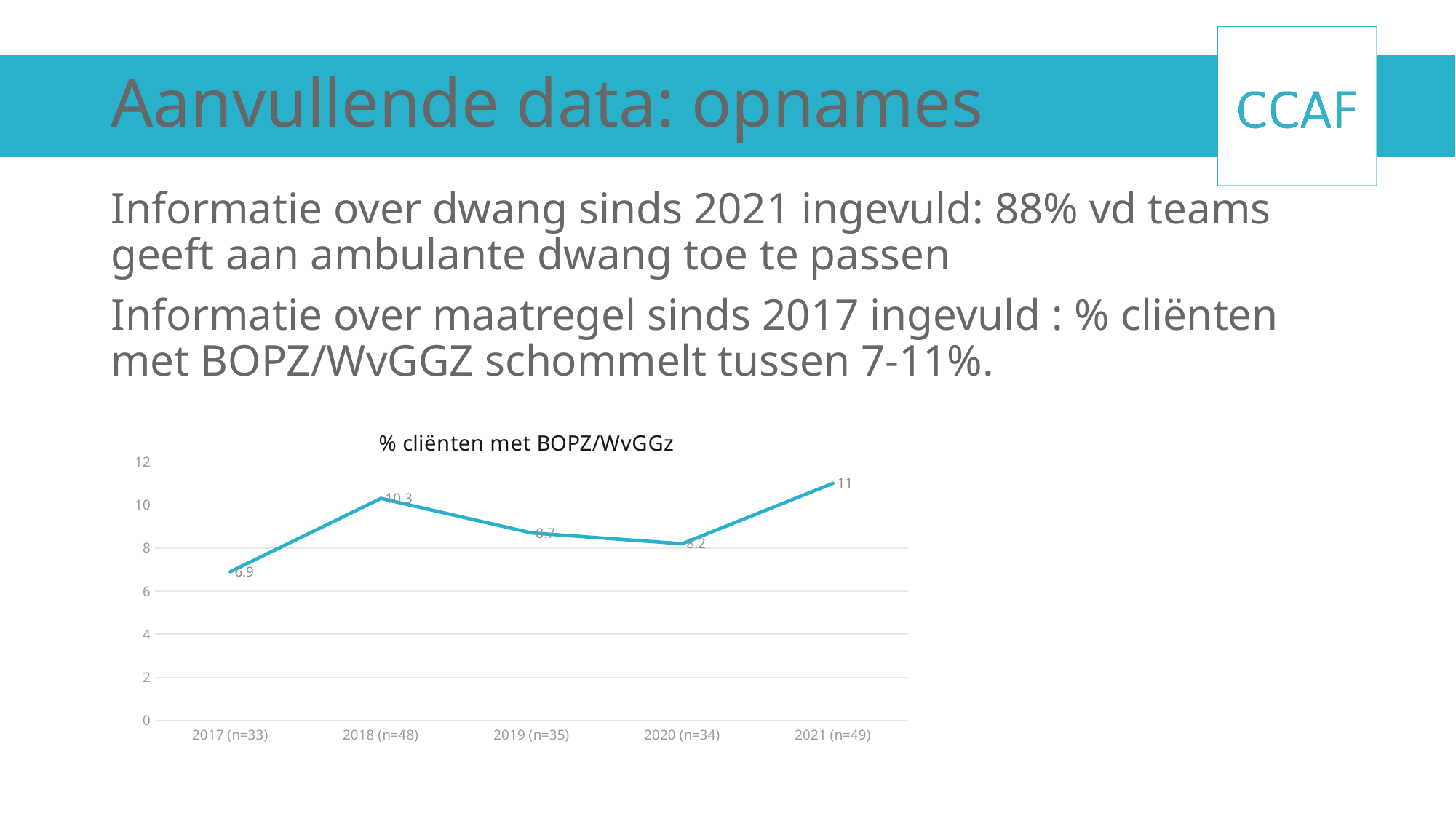
What is the value for 2017 (n=33)? 6.9 What kind of chart is shown on the slide? line chart How many data points are plotted on the chart? 5 What is the title of the chart? % cliënten met BOPZ/WvGGz What is the difference between the values for 2021 (n=49) and 2017 (n=33)? 4.1 Which year has the lowest value? 2017 (n=33) What is the value for 2019 (n=35)? 8.7 What is the value for 2020 (n=34)? 8.2 What is the value for 2021 (n=49)? 11 What is the value for 2018 (n=48)? 10.3 Which year has the highest value? 2021 (n=49) Which is larger, the value for 2018 (n=48) or the value for 2019 (n=35)? 2018 (n=48)